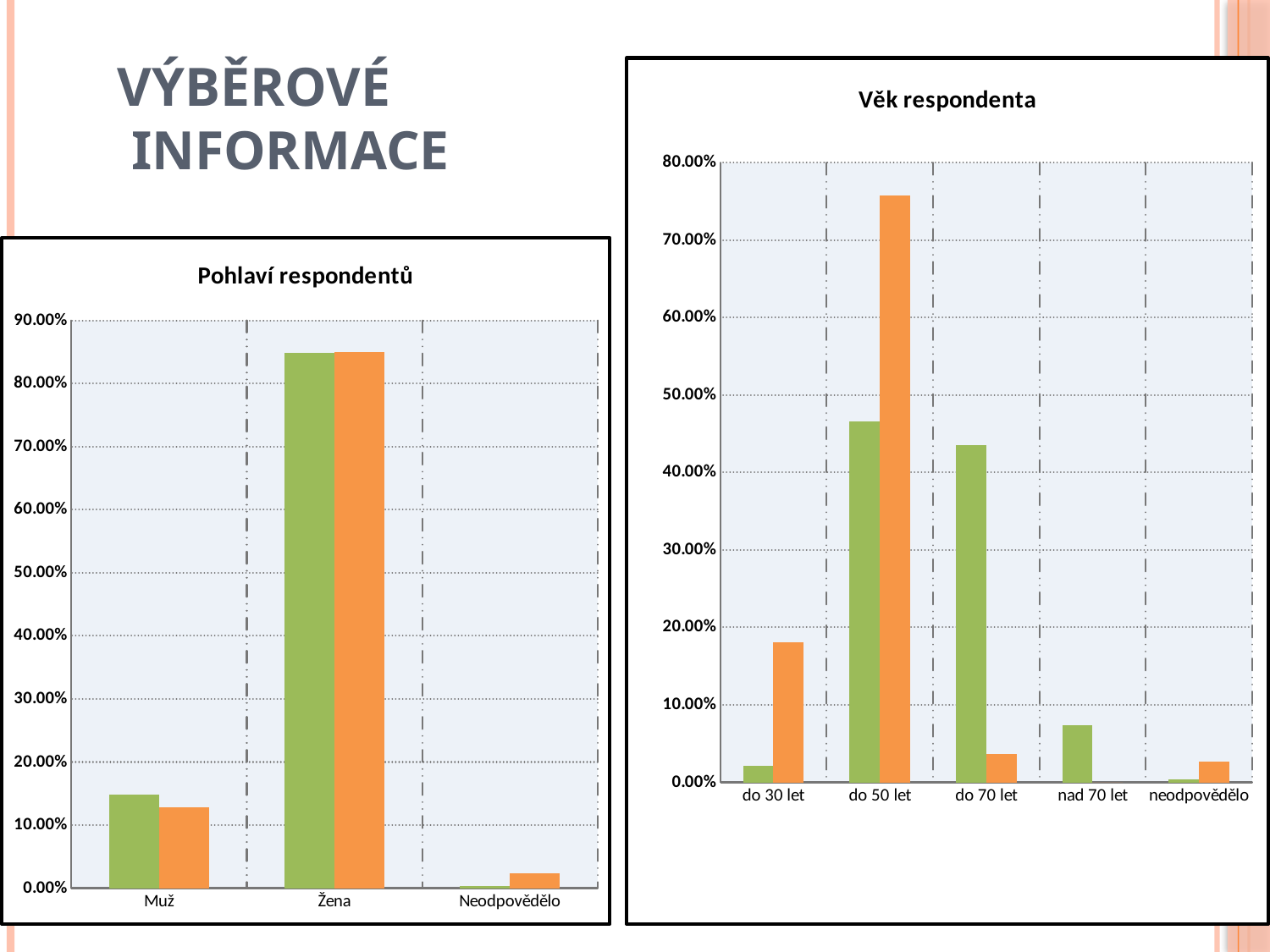
In the "Věk respondenta" chart, which is larger for "do 30 let": the green bar or the orange bar? the orange bar In the "Věk respondenta" chart, is the orange bar for "do 50 let" greater or less than 70.00%? greater What is the highest value shown on the y axis of the "Pohlaví respondentů" chart? 90.00% What kind of chart is the "Pohlaví respondentů" chart? bar chart In the "Věk respondenta" chart, which category has the tallest bar? do 50 let In the "Věk respondenta" chart, is the green bar for "do 70 let" greater or less than 50.00%? less In the "Pohlaví respondentů" chart, which category has the highest bars? Žena In the "Věk respondenta" chart, which is larger for "do 70 let": the green bar or the orange bar? the green bar How many categories are shown on the x axis of the "Věk respondenta" chart? 5 What is the title of the chart on the right side of the slide? Věk respondenta In the "Pohlaví respondentů" chart, is the green bar for "Muž" greater or less than 20.00%? less How many categories are shown on the x axis of the "Pohlaví respondentů" chart? 3